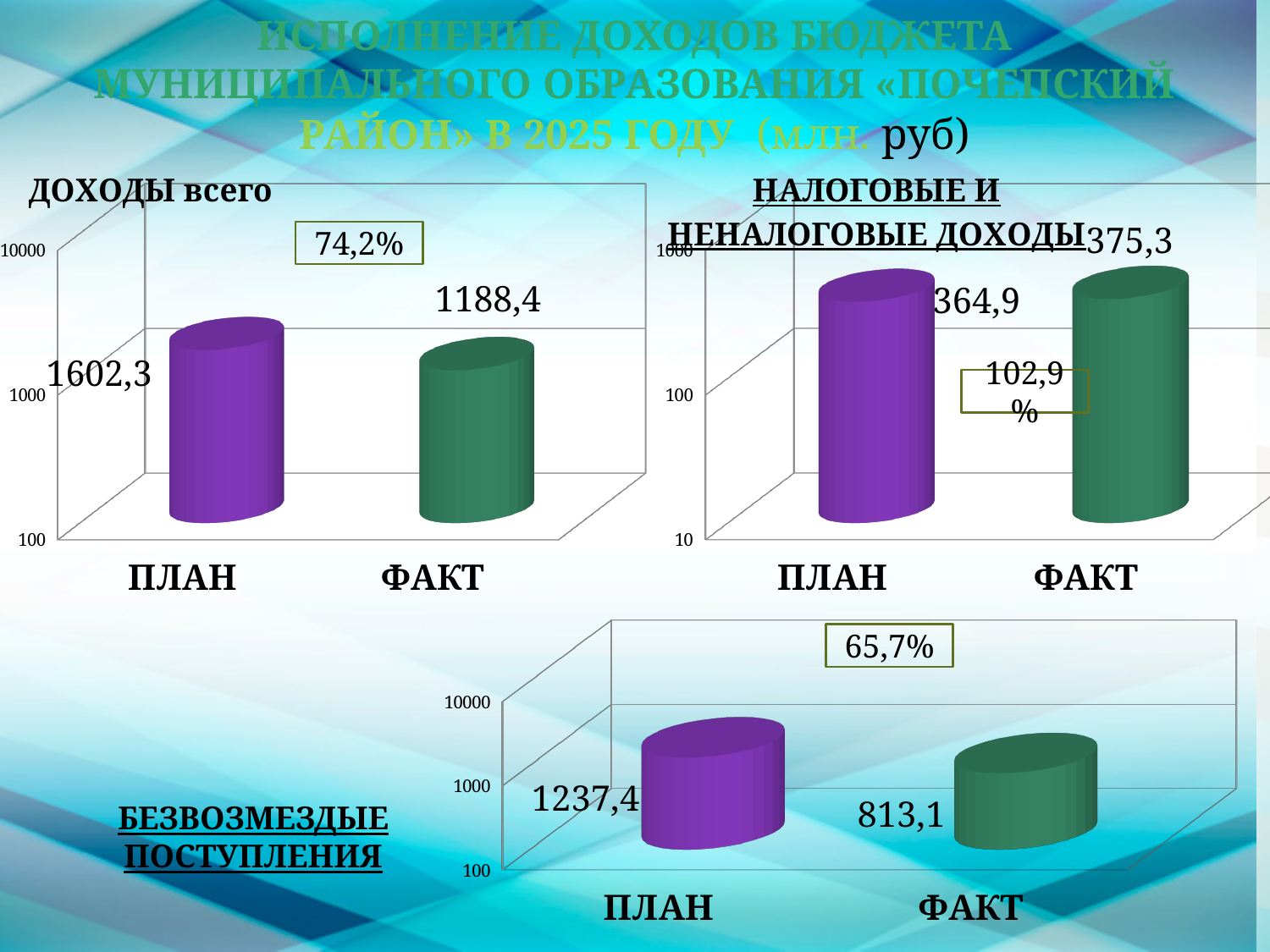
In the 'БЕЗВОЗМЕЗДЫЕ ПОСТУПЛЕНИЯ' chart, what is the value for ФАКТ? 813,1 In the 'НАЛОГОВЫЕ И НЕНАЛОГОВЫЕ ДОХОДЫ' chart, what is the value for ФАКТ? 375,3 How many categories are shown in the 'ДОХОДЫ всего' chart? 2 What percentage is shown in the box on the 'БЕЗВОЗМЕЗДЫЕ ПОСТУПЛЕНИЯ' chart? 65,7% In the 'БЕЗВОЗМЕЗДЫЕ ПОСТУПЛЕНИЯ' chart, which category has the highest value? ПЛАН In the 'ДОХОДЫ всего' chart, what is the value for ПЛАН? 1602,3 In the 'ДОХОДЫ всего' chart, which category has the lowest value? ФАКТ In the 'ДОХОДЫ всего' chart, what is the difference between the ПЛАН and ФАКТ values? 413,9 In the 'БЕЗВОЗМЕЗДЫЕ ПОСТУПЛЕНИЯ' chart, what is the difference between the ПЛАН and ФАКТ values? 424,3 In the 'ДОХОДЫ всего' chart, what is the value for ФАКТ? 1188,4 In the 'НАЛОГОВЫЕ И НЕНАЛОГОВЫЕ ДОХОДЫ' chart, which is larger, ПЛАН or ФАКТ? ФАКТ In the 'НАЛОГОВЫЕ И НЕНАЛОГОВЫЕ ДОХОДЫ' chart, what is the value for ПЛАН? 364,9